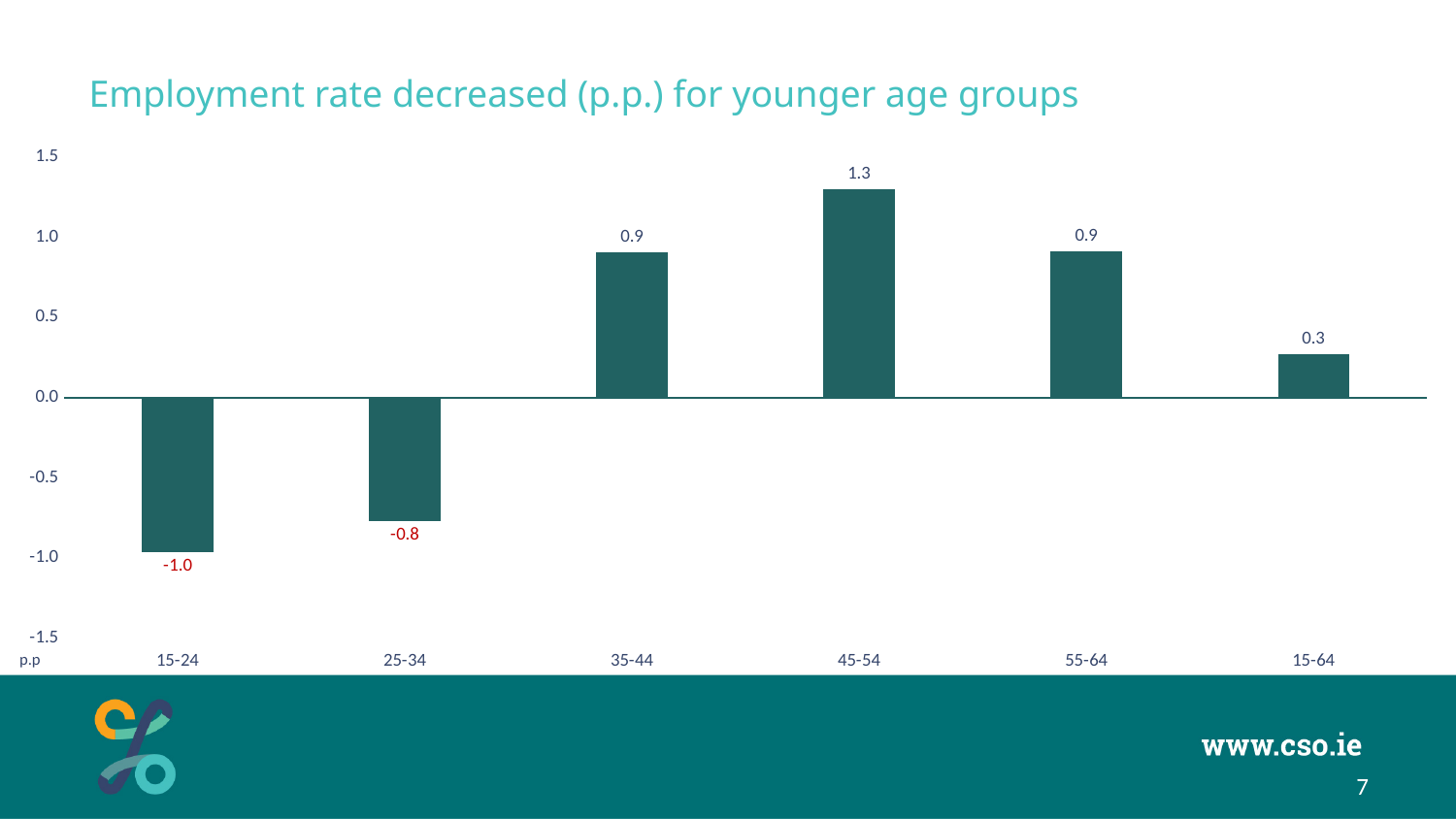
What is the title of the chart? Employment rate decreased (p.p.) for younger age groups What is the difference between the values for 25-34 and 15-24? 0.2 What is the difference between the values for 45-54 and 55-64? 0.4 How many age groups have a negative value? 2 Which age group has the lowest value? 15-24 What is the value for the 45-54 age group? 1.3 What kind of chart is shown on the slide? Bar chart What is the value for the 15-24 age group? -1.0 Which is larger, the value for 35-44 or the value for 15-64? 35-44 What is the value for the 15-64 age group? 0.3 Which age group has the highest value? 45-54 How many age groups are shown on the x axis? 6